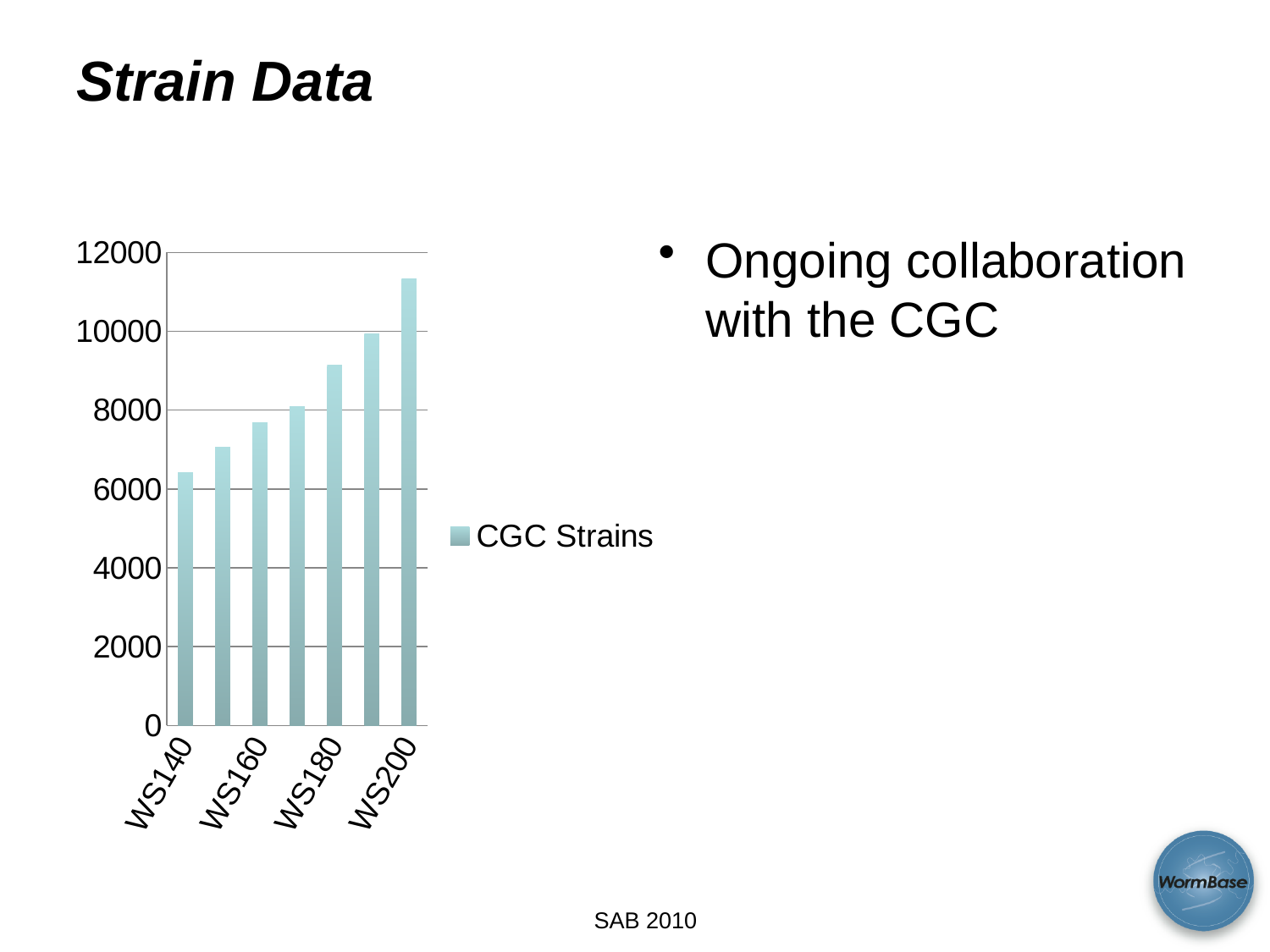
Is the value for WS180 greater or less than 10000? less Is the value for WS140 greater or less than 6000? greater Is the value for WS160 greater or less than 8000? less How many series does the legend list? 1 How many bars are plotted in the chart? 7 What is the name of the series shown in the legend? CGC Strains Which is larger, the value for WS180 or the value for WS160? WS180 Do the values rise or fall from WS140 to WS200? rise Which labelled category has the lowest value? WS140 Which labelled category has the highest value? WS200 What kind of chart is shown on the slide? bar chart